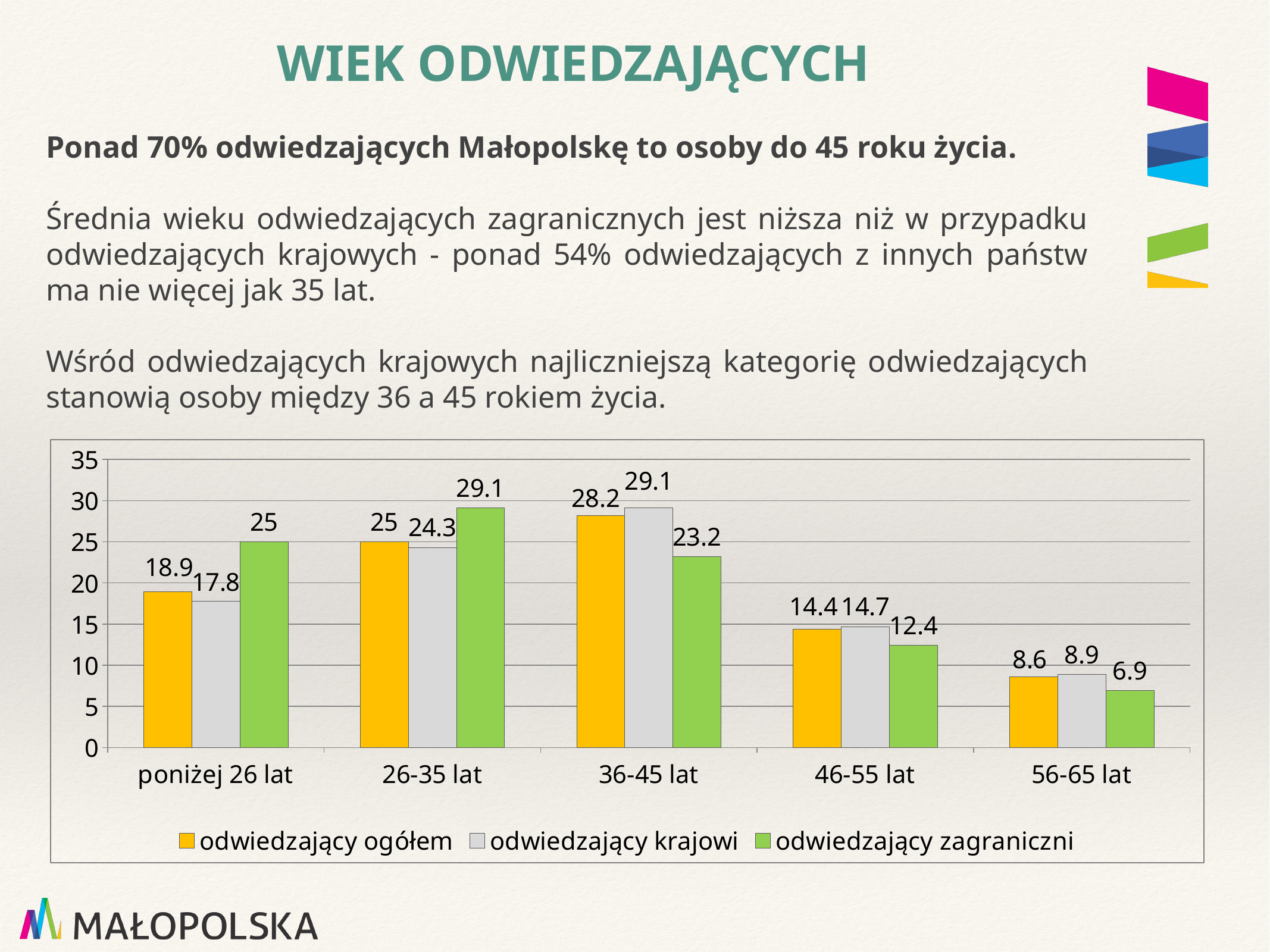
What type of chart is shown on the slide? bar chart How many age categories are shown on the x axis of the chart? 5 What is the difference between 'odwiedzający krajowi' and 'odwiedzający zagraniczni' in the '36-45 lat' category? 5.9 Do the values for 'odwiedzający ogółem' rise or fall from '36-45 lat' to '56-65 lat'? fall What is the value for 'odwiedzający zagraniczni' in the '26-35 lat' category? 29.1 Which age category has the highest value for 'odwiedzający krajowi'? 36-45 lat Which colour represents 'odwiedzający zagraniczni' in the chart? green What is the value for 'odwiedzający ogółem' in the '56-65 lat' category? 8.6 Which age category has the lowest value for 'odwiedzający zagraniczni'? 56-65 lat How many series does the chart legend list? 3 What is the value for 'odwiedzający krajowi' in the 'poniżej 26 lat' category? 17.8 In the 'poniżej 26 lat' category, which is larger: 'odwiedzający zagraniczni' or 'odwiedzający ogółem'? odwiedzający zagraniczni